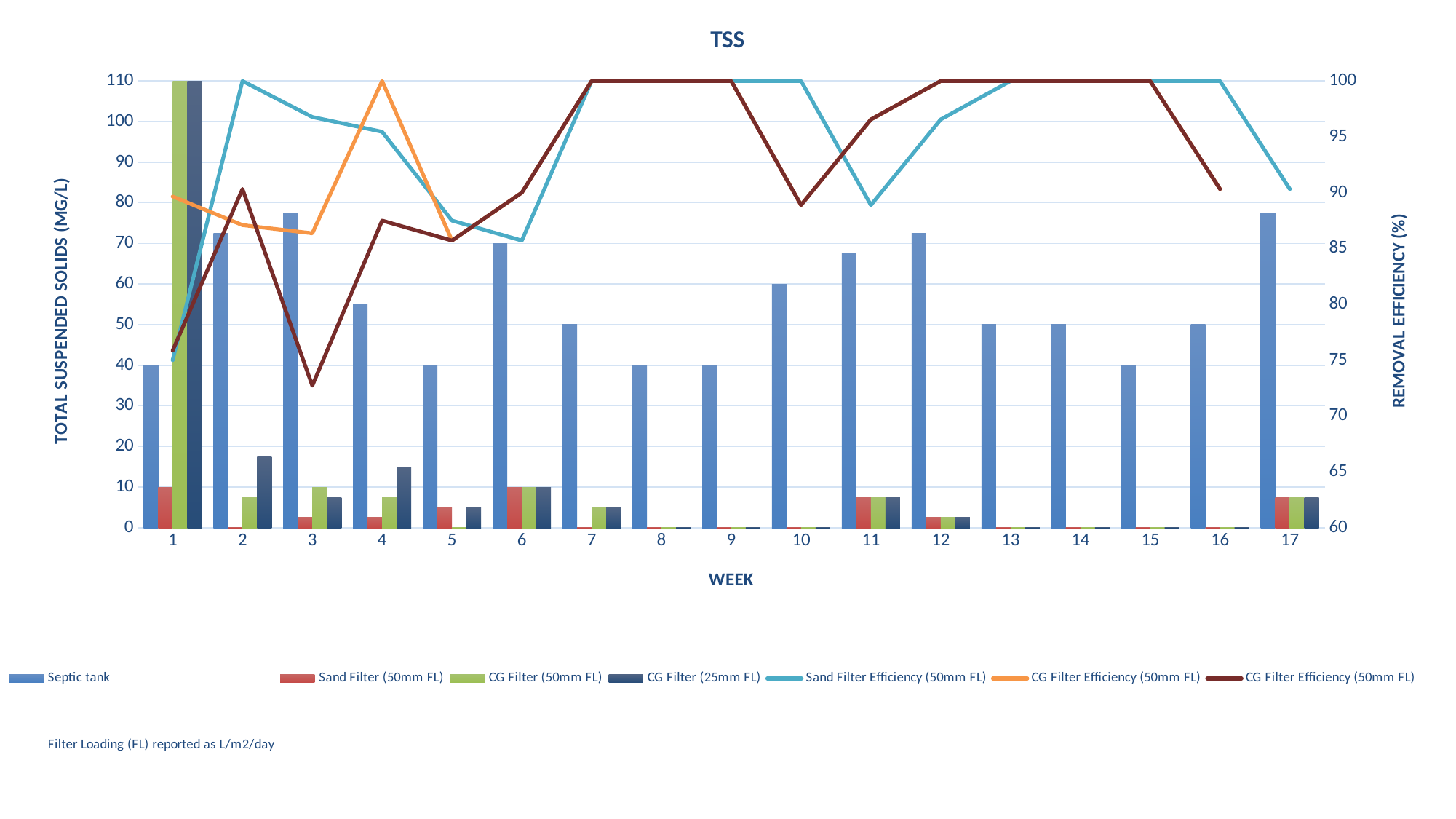
What is the title of the chart? TSS What is the Septic tank value in week 10? 60 What is the Sand Filter Efficiency (50mm FL) in week 2? 100 What is the difference between the Septic tank values in week 10 and week 9? 20 What is the Septic tank value in week 9? 40 How many weeks are shown on the x axis? 17 Is the Septic tank value in week 3 greater or less than 70? greater How many series does the legend list? 7 What type of chart is shown on the slide? Combined bar and line chart Which is larger, the Septic tank value in week 6 or in week 7? Week 6 Is the Septic tank value in week 11 greater or less than 60? greater Does the Sand Filter Efficiency (50mm FL) line rise or fall from week 2 to week 6? Fall